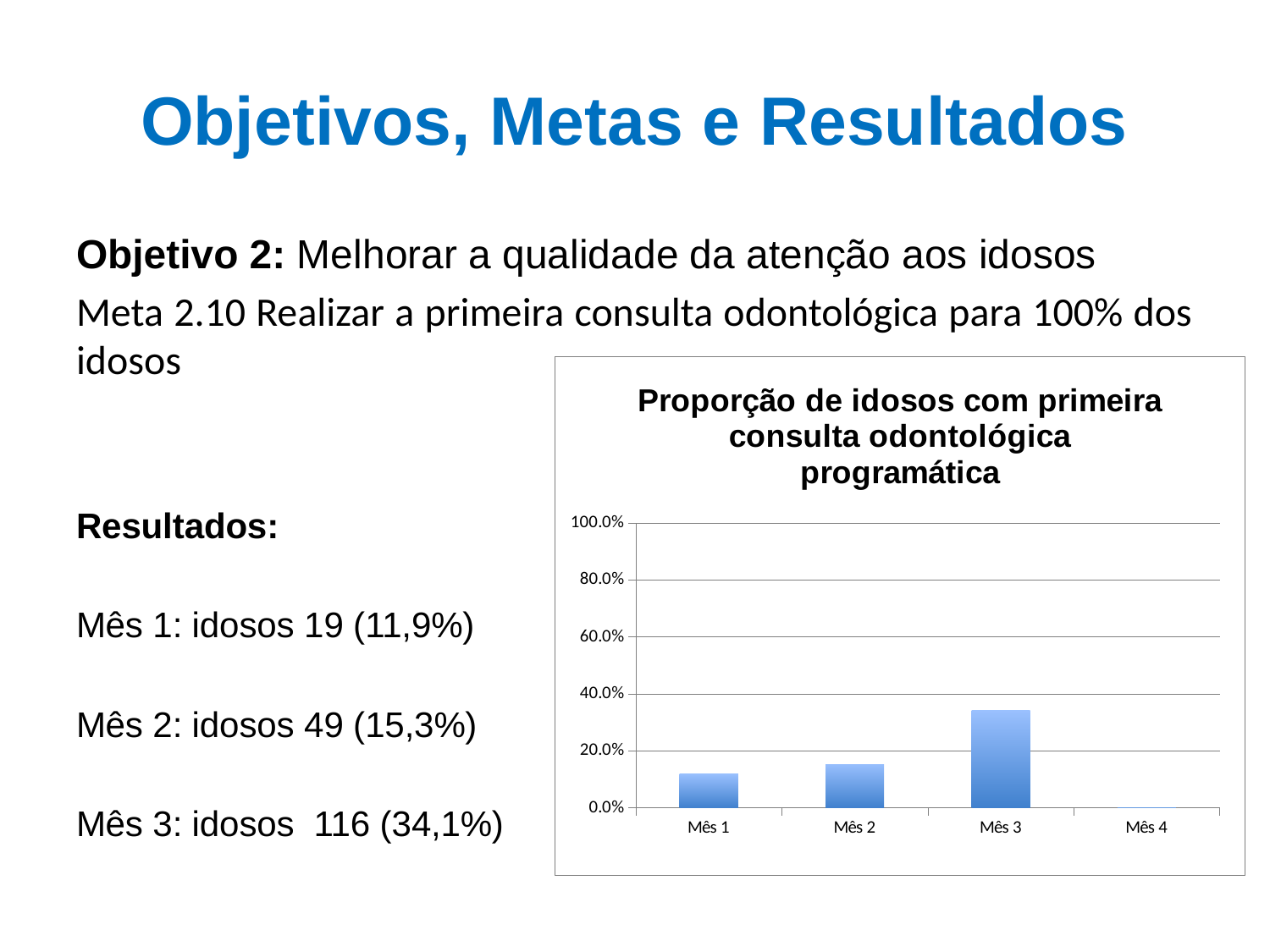
Is the value for Mês 3 greater or less than 20.0%? greater What is the title of the chart? Proporção de idosos com primeira consulta odontológica programática Which is larger, the value for Mês 2 or the value for Mês 1? Mês 2 Is the value for Mês 1 greater or less than 20.0%? less How many categories are shown on the x axis of the chart? 4 Which month has the lowest bar in the chart? Mês 4 Is the value for Mês 3 greater or less than 40.0%? less What kind of chart is shown on the slide? bar chart Which month has the highest bar in the chart? Mês 3 What is the highest value shown on the y axis of the chart? 100.0% Do the values rise or fall from Mês 1 to Mês 3? rise